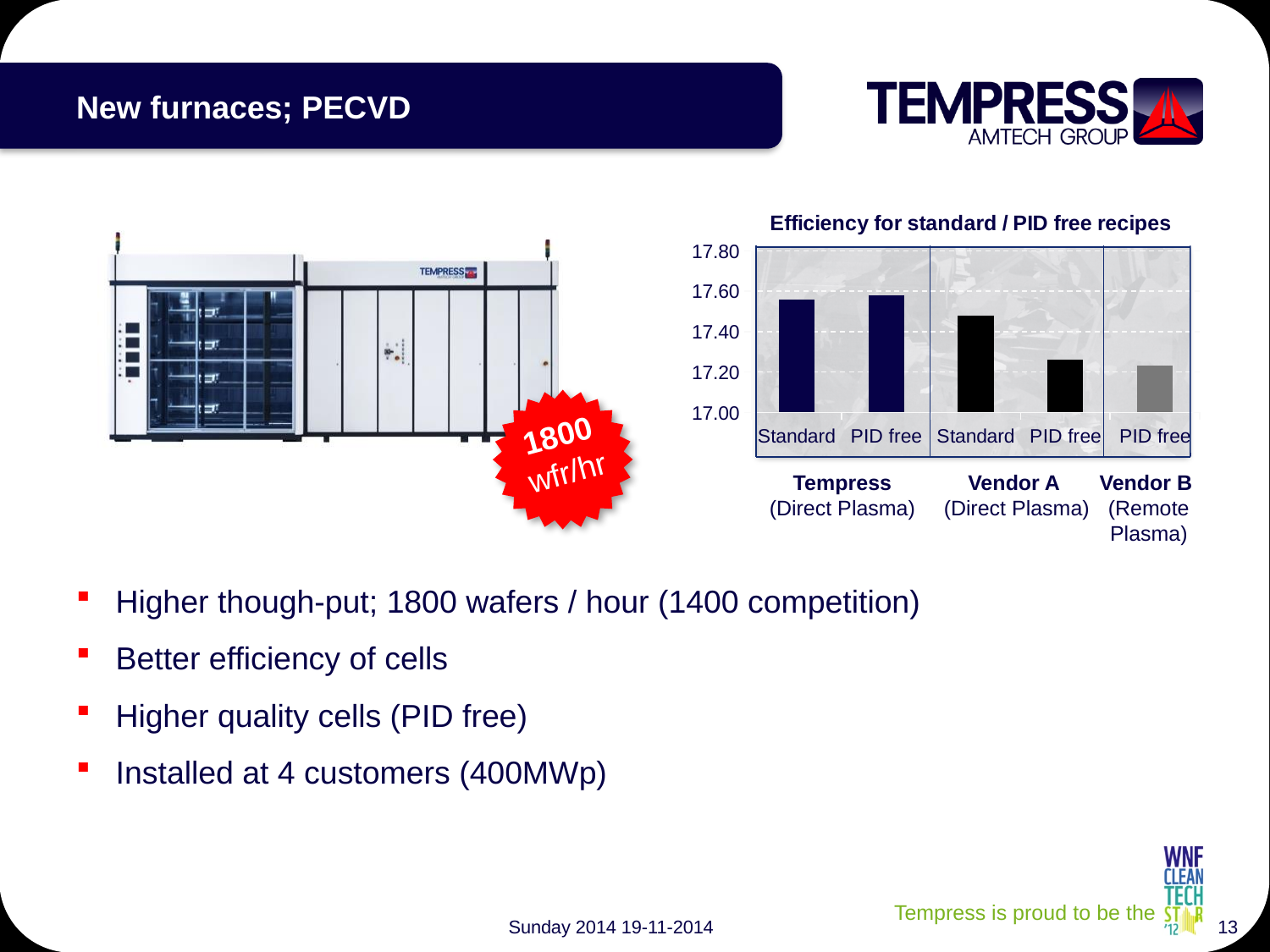
How many bars are plotted in the chart? 5 Which is larger, the Tempress PID free value or the Vendor B PID free value? Tempress PID free Is the value for the Vendor A PID free recipe greater or less than 17.40? less Which is larger, the Tempress Standard value or the Vendor A Standard value? Tempress Standard What plasma type is listed under Vendor B in the chart? Remote Plasma Which is larger, the Vendor A Standard value or the Vendor A PID free value? Vendor A Standard What is the title of the chart? Efficiency for standard / PID free recipes Is the value for the Vendor B PID free recipe greater or less than 17.40? less Is the value for the Tempress Standard recipe greater or less than 17.40? greater What kind of chart is shown on the slide? bar chart How many vendor groups are shown along the x axis of the chart? 3